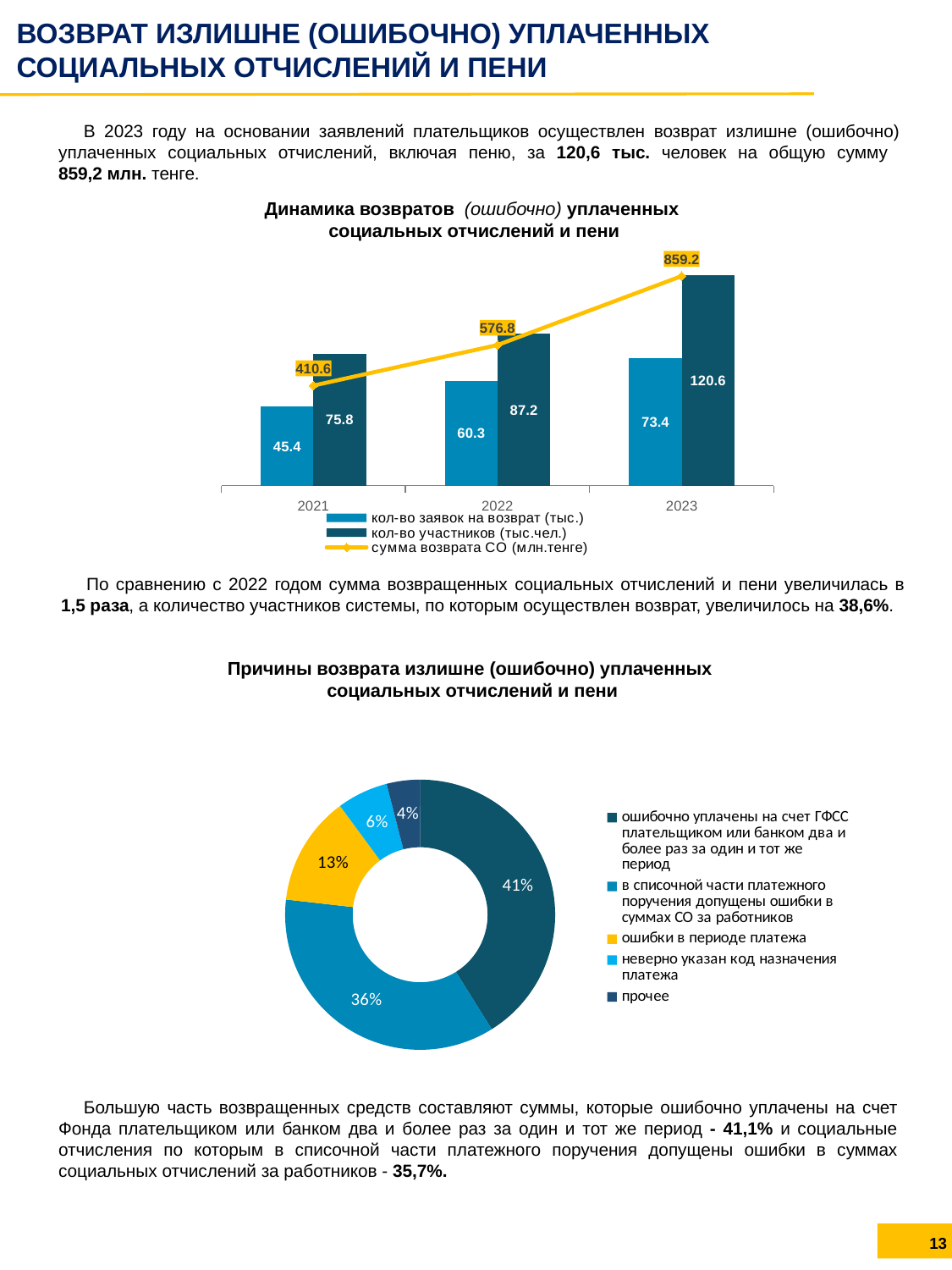
What kind of chart is 'Причины возврата излишне (ошибочно) уплаченных социальных отчислений и пени'? doughnut (pie) chart In the chart 'Динамика возвратов (ошибочно) уплаченных социальных отчислений и пени', what is the value of 'сумма возврата СО (млн.тенге)' for 2023? 859.2 In the chart 'Динамика возвратов (ошибочно) уплаченных социальных отчислений и пени', what is the value of 'кол-во участников (тыс.чел.)' for 2021? 75.8 In the chart 'Динамика возвратов (ошибочно) уплаченных социальных отчислений и пени', which is larger in 2021: 'кол-во заявок на возврат (тыс.)' or 'кол-во участников (тыс.чел.)'? кол-во участников (тыс.чел.) In the chart 'Причины возврата излишне (ошибочно) уплаченных социальных отчислений и пени', what share does 'ошибки в периоде платежа' have? 13% In the chart 'Динамика возвратов (ошибочно) уплаченных социальных отчислений и пени', what is the value of 'кол-во заявок на возврат (тыс.)' for 2022? 60.3 In the chart 'Причины возврата излишне (ошибочно) уплаченных социальных отчислений и пени', which category has the largest share? ошибочно уплачены на счет ГФСС плательщиком или банком два и более раз за один и тот же период In the chart 'Динамика возвратов (ошибочно) уплаченных социальных отчислений и пени', what is the difference between 'кол-во участников (тыс.чел.)' in 2023 and 2022? 33.4 In the chart 'Динамика возвратов (ошибочно) уплаченных социальных отчислений и пени', how many years are shown on the x axis? 3 In the chart 'Динамика возвратов (ошибочно) уплаченных социальных отчислений и пени', how many series does the legend list? 3 In the chart 'Динамика возвратов (ошибочно) уплаченных социальных отчислений и пени', which year has the lowest value of 'сумма возврата СО (млн.тенге)'? 2021 In the chart 'Динамика возвратов (ошибочно) уплаченных социальных отчислений и пени', does 'сумма возврата СО (млн.тенге)' rise or fall from 2021 to 2023? rise